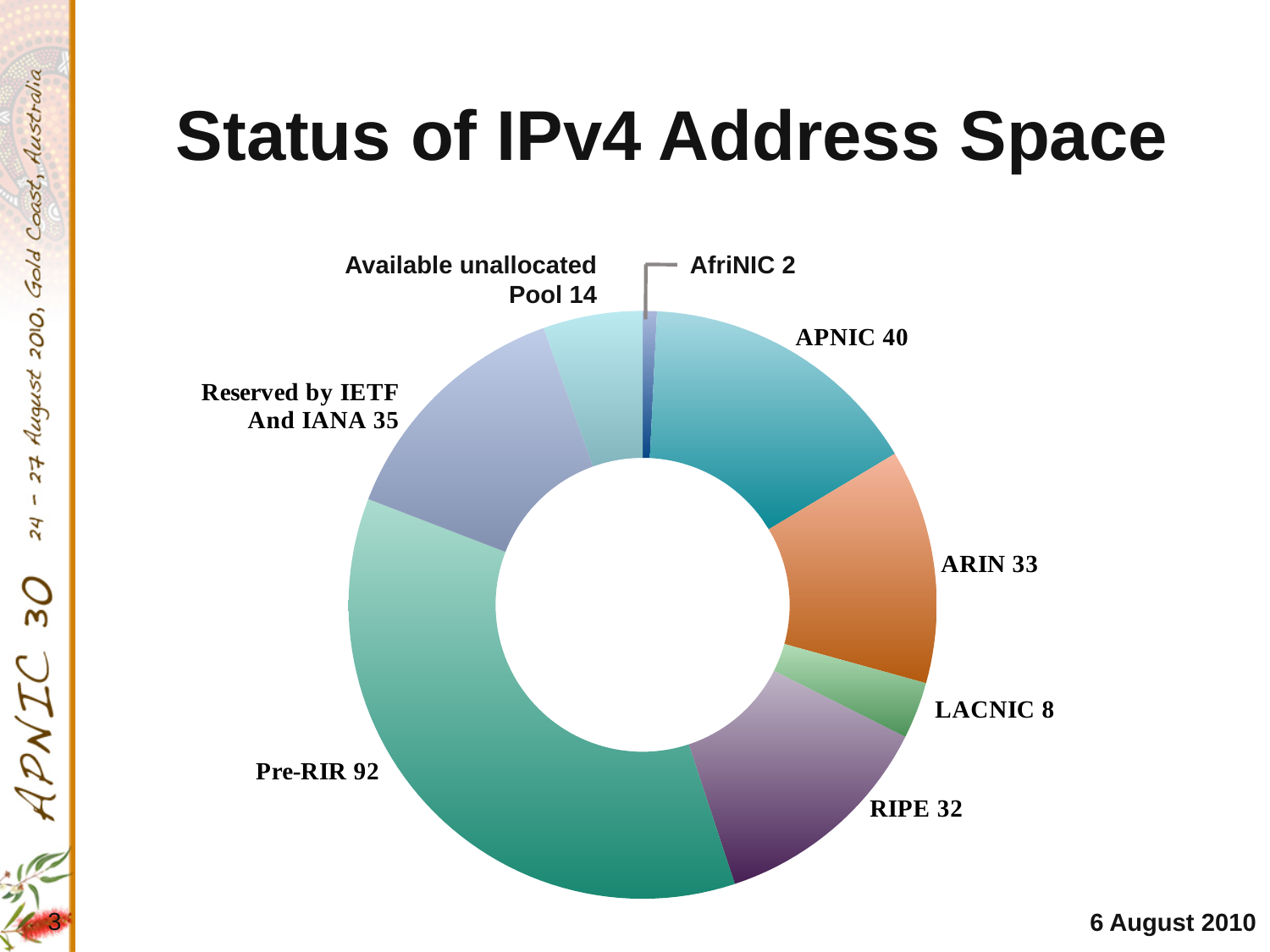
Which segment of the chart has the largest value? Pre-RIR What is the difference between the Pre-RIR value and the Reserved by IETF And IANA value? 57 What kind of chart is shown on the slide? doughnut chart Which segment of the chart has the smallest value? AfriNIC What value is shown for the Available unallocated Pool? 14 What value is shown for Reserved by IETF And IANA? 35 What value is shown for Pre-RIR in the chart? 92 What is the difference between the APNIC value and the ARIN value? 7 What is the title of the slide containing the chart? Status of IPv4 Address Space Which is larger, the value for RIPE or the value for LACNIC? RIPE How many segments does the chart have? 8 What value is shown for APNIC in the chart? 40